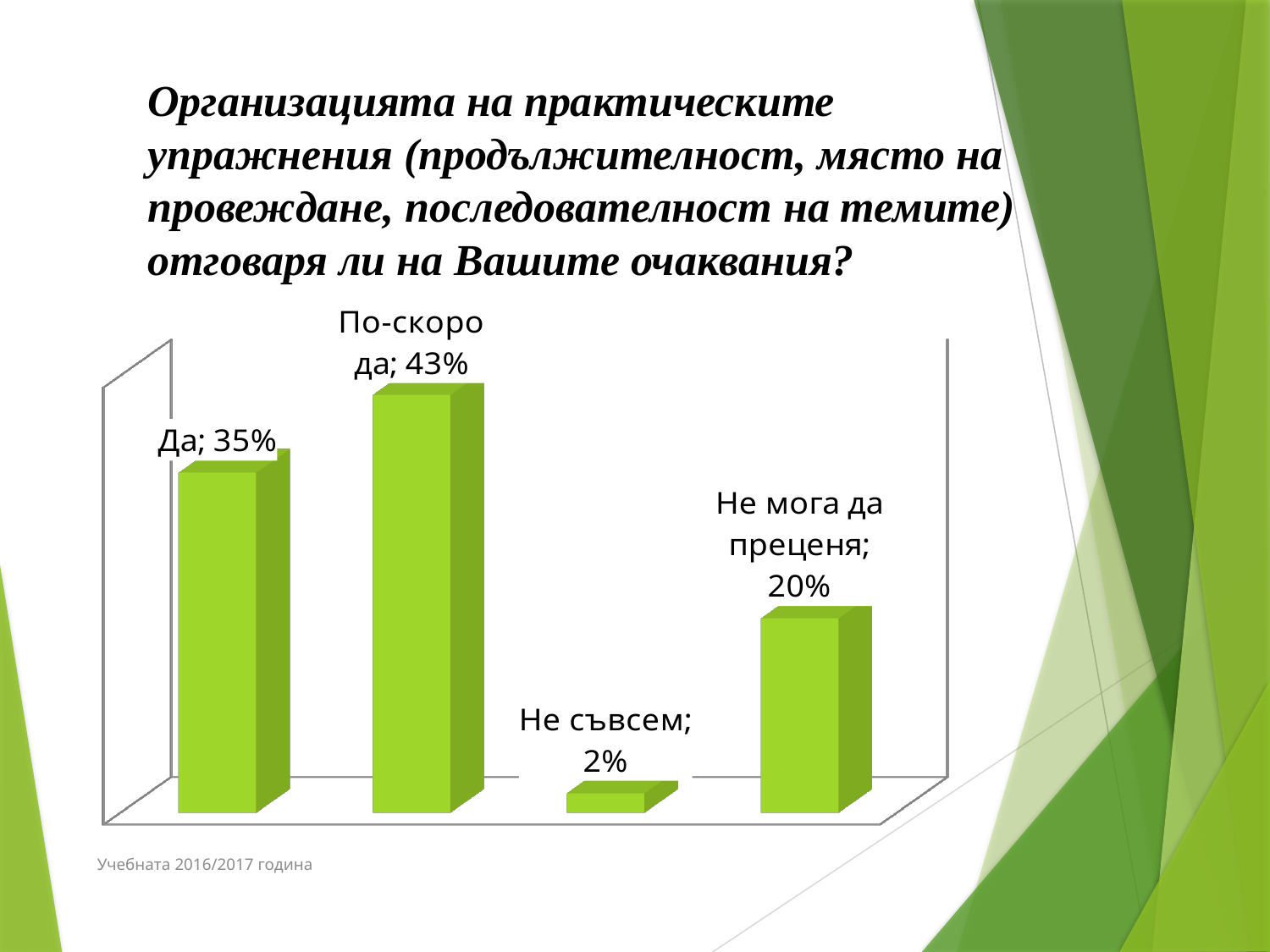
What kind of chart is shown on the slide? Bar chart What is the value for "Не съвсем"? 2% What is the difference between the values for "По-скоро да" and "Да"? 8% What is the value for "По-скоро да"? 43% How many categories are shown in the chart? 4 Which is larger, the value for "Да" or the value for "Не мога да преценя"? Да What is the value for "Да"? 35% What is the difference between the values for "Не мога да преценя" and "Не съвсем"? 18% What is the value for "Не мога да преценя"? 20% What colour are the bars in the chart? Green Which category has the lowest value? Не съвсем Which category has the highest value? По-скоро да